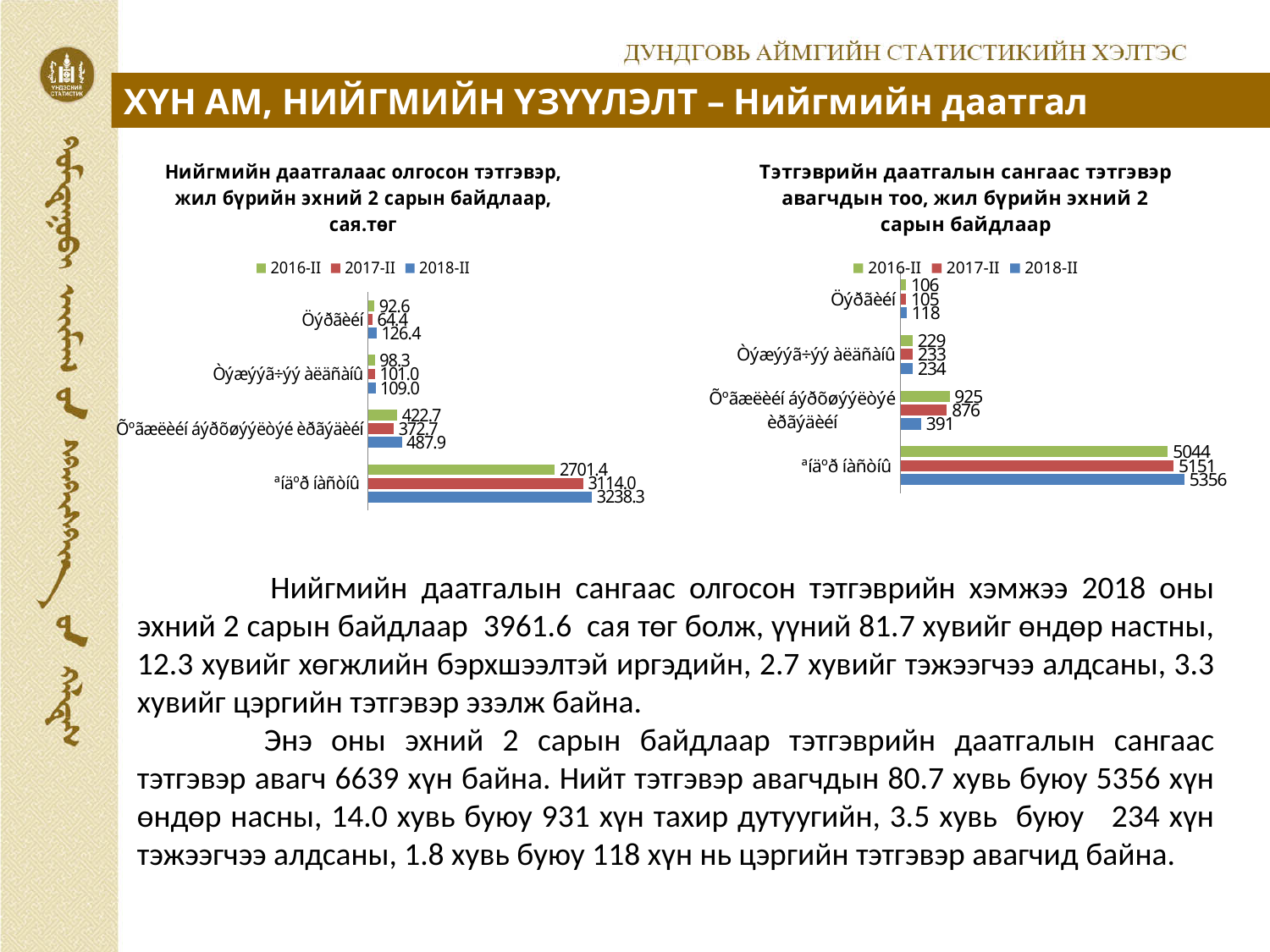
How many categories are plotted in the left chart? 4 In the left chart, what is the difference between the 2018-II and 2017-II values for the bottom category? 124.3 In the left chart, what is the 2018-II value for the bottom category? 3238.3 In the right chart, what is the difference between the 2018-II and 2016-II values for the bottom category? 312 In the left chart, which series has the highest value for the bottom category? 2018-II In the right chart, what is the 2016-II value for the bottom category? 5044 In the left chart, what is the 2017-II value for the top category? 64.4 What type of chart is the left chart titled 'Нийгмийн даатгалаас олгосон тэтгэвэр'? bar chart How many series does the legend of the left chart list? 3 In the right chart titled 'Тэтгэврийн даатгалын сангаас тэтгэвэр авагчдын тоо', what is the 2018-II value for the bottom category? 5356 In the left chart, which series has the lowest value for the top category? 2017-II In the right chart, for the third category from the top, which is larger: the 2016-II value or the 2018-II value? 2016-II